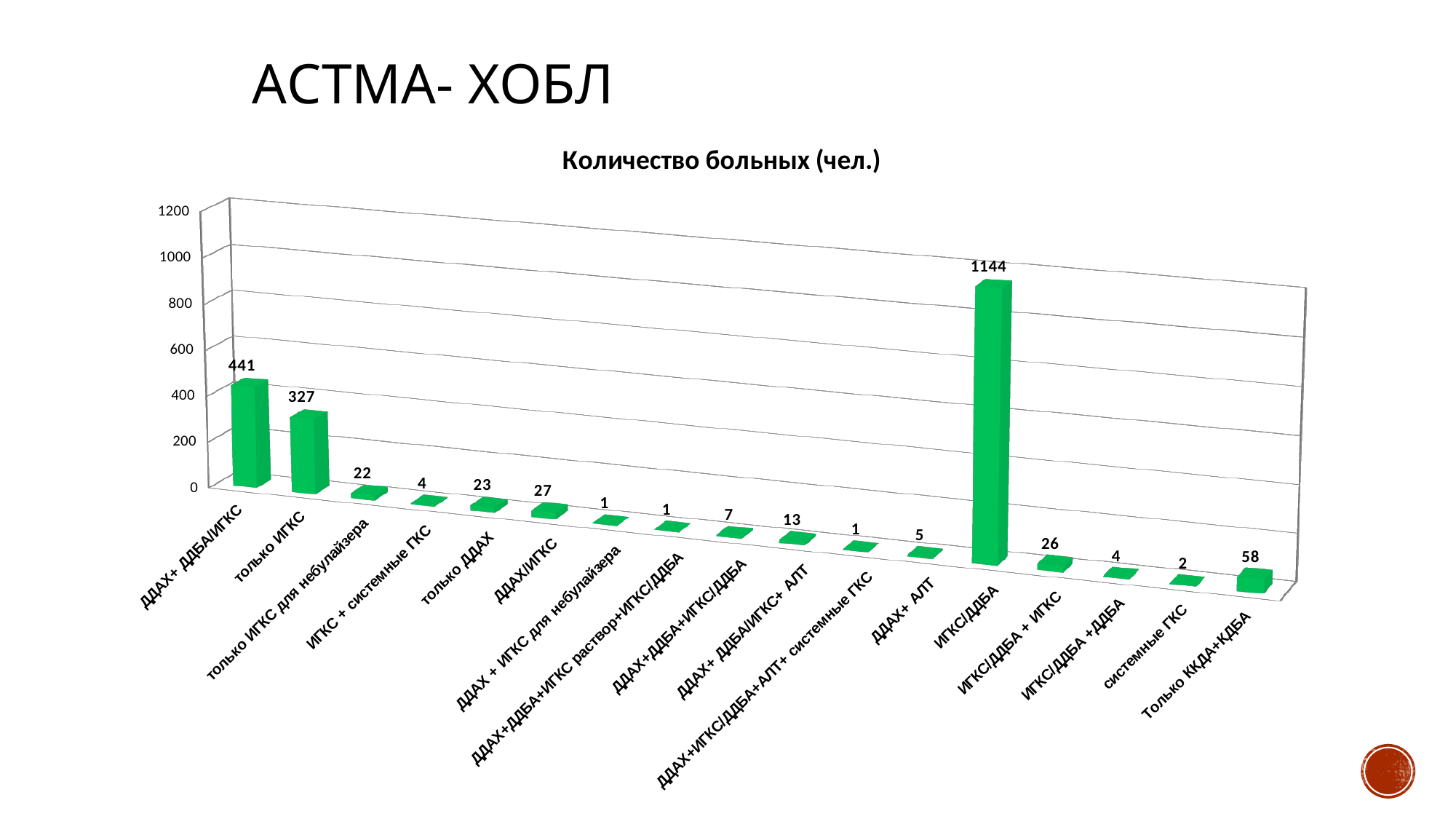
What is the title of the chart? Количество больных (чел.) What is the difference between the values for ИГКС/ДДБА and ДДАХ+ ДДБА/ИГКС? 703 What is the value for ДДАХ+ ДДБА/ИГКС+ АЛТ? 13 What is the value for только ИГКС? 327 What is the value for Только ККДА+КДБА? 58 How many categories are shown on the x axis of the chart? 17 What is the value for ДДАХ+ ДДБА/ИГКС? 441 What is the smallest value shown on the chart? 1 What type of chart is shown on the slide? bar chart Which category has the highest number of patients? ИГКС/ДДБА Which is larger, the value for только ДДАХ or the value for ДДАХ/ИГКС? ДДАХ/ИГКС What is the value for ИГКС/ДДБА? 1144